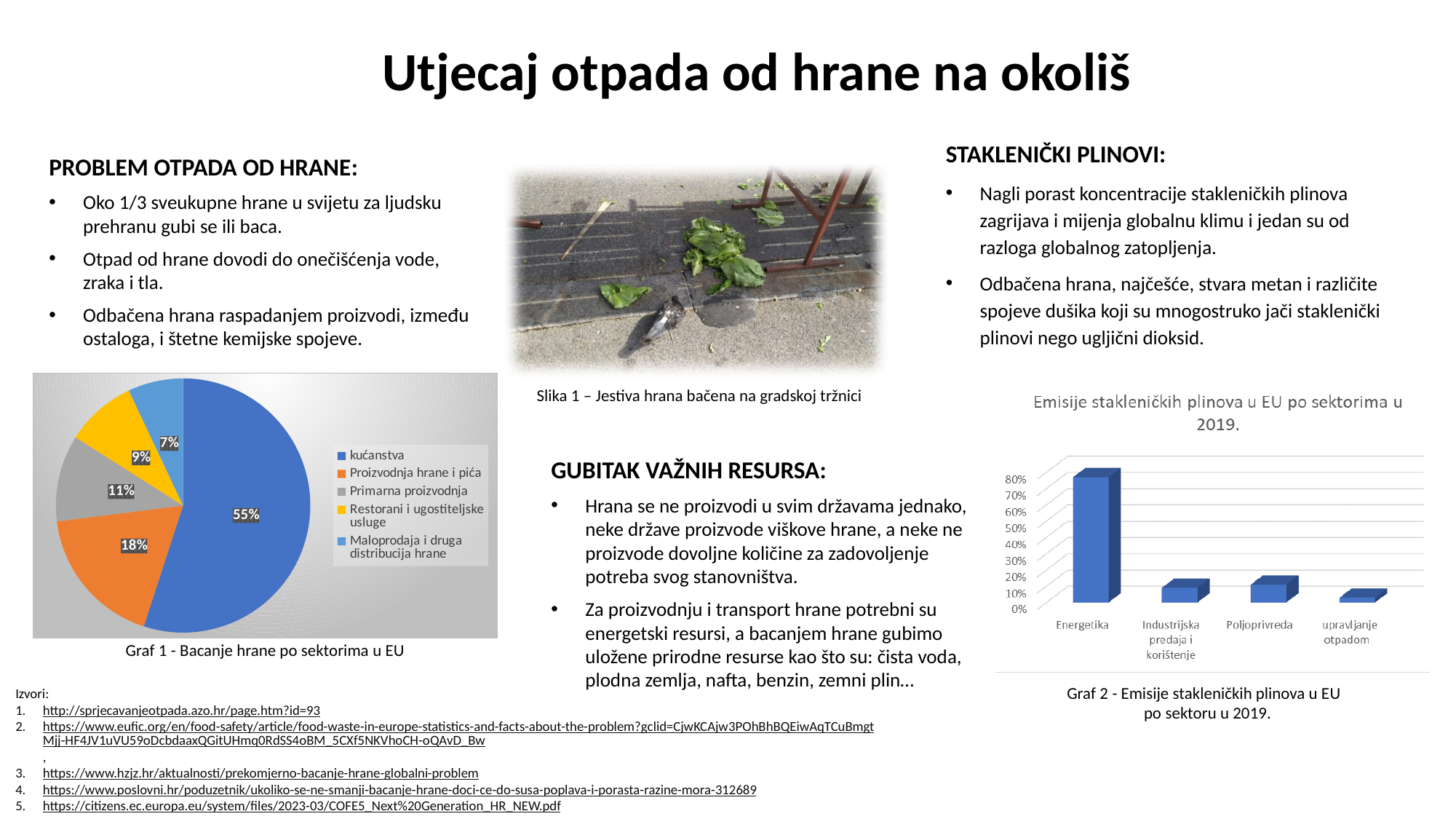
What kind of chart is Emisije stakleničkih plinova u EU po sektorima u 2019.? bar chart In the chart Emisije stakleničkih plinova u EU po sektorima u 2019., is the value for Energetika greater or less than 70%? greater In the pie chart Graf 1 - Bacanje hrane po sektorima u EU, which sector has the smallest slice? Maloprodaja i druga distribucija hrane In the pie chart Graf 1 - Bacanje hrane po sektorima u EU, how many percentage points larger is the kućanstva slice than the Proizvodnja hrane i pića slice? 37% What kind of chart is Graf 1 - Bacanje hrane po sektorima u EU? pie chart In the pie chart Graf 1 - Bacanje hrane po sektorima u EU, what share is shown for Proizvodnja hrane i pića? 18% In the pie chart Graf 1 - Bacanje hrane po sektorima u EU, what share is shown for kućanstva? 55% In the pie chart Graf 1 - Bacanje hrane po sektorima u EU, which sector has the largest slice? kućanstva In the pie chart Graf 1 - Bacanje hrane po sektorima u EU, what share is shown for Restorani i ugostiteljske usluge? 9% In the chart Emisije stakleničkih plinova u EU po sektorima u 2019., which sector has the highest value? Energetika In the chart Emisije stakleničkih plinova u EU po sektorima u 2019., which sector has the lowest value? upravljanje otpadom In the pie chart Graf 1 - Bacanje hrane po sektorima u EU, how many entries does the legend list? 5